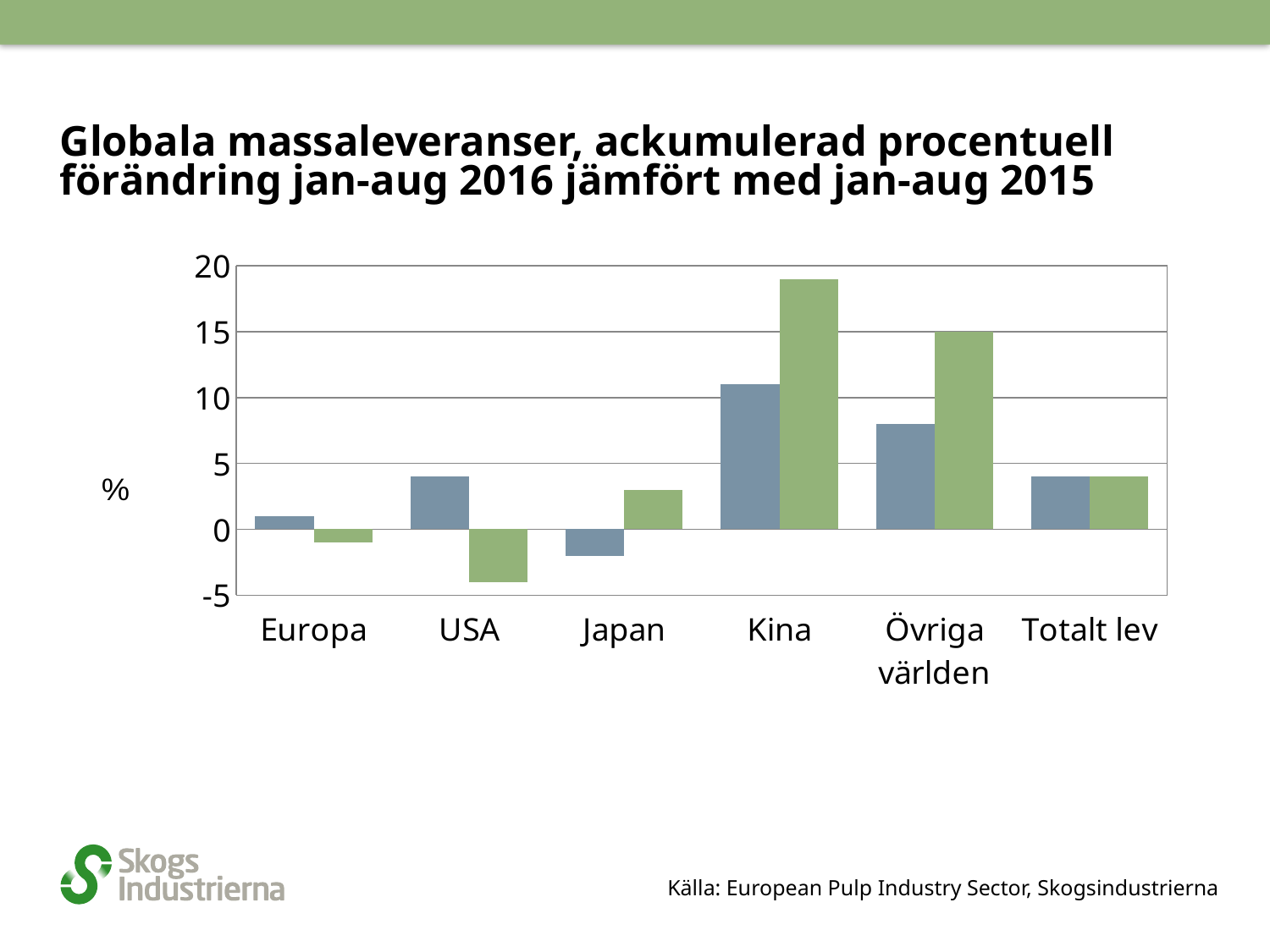
What kind of chart is shown on the slide? bar chart Is the value of the green bar for Kina greater or less than 15? greater How many categories are shown on the x axis of the chart? 6 Which category has the highest bar in the chart? Kina Which is larger, the blue bar for USA or the blue bar for Europa? USA What label is shown on the vertical axis of the chart? % Which category has the lowest bar in the chart? USA Is the value of the green bar for USA greater or less than 0? less Is the value of the blue bar for Kina greater or less than 10? greater Which is larger, the green bar for Kina or the green bar for Övriga världen? Kina